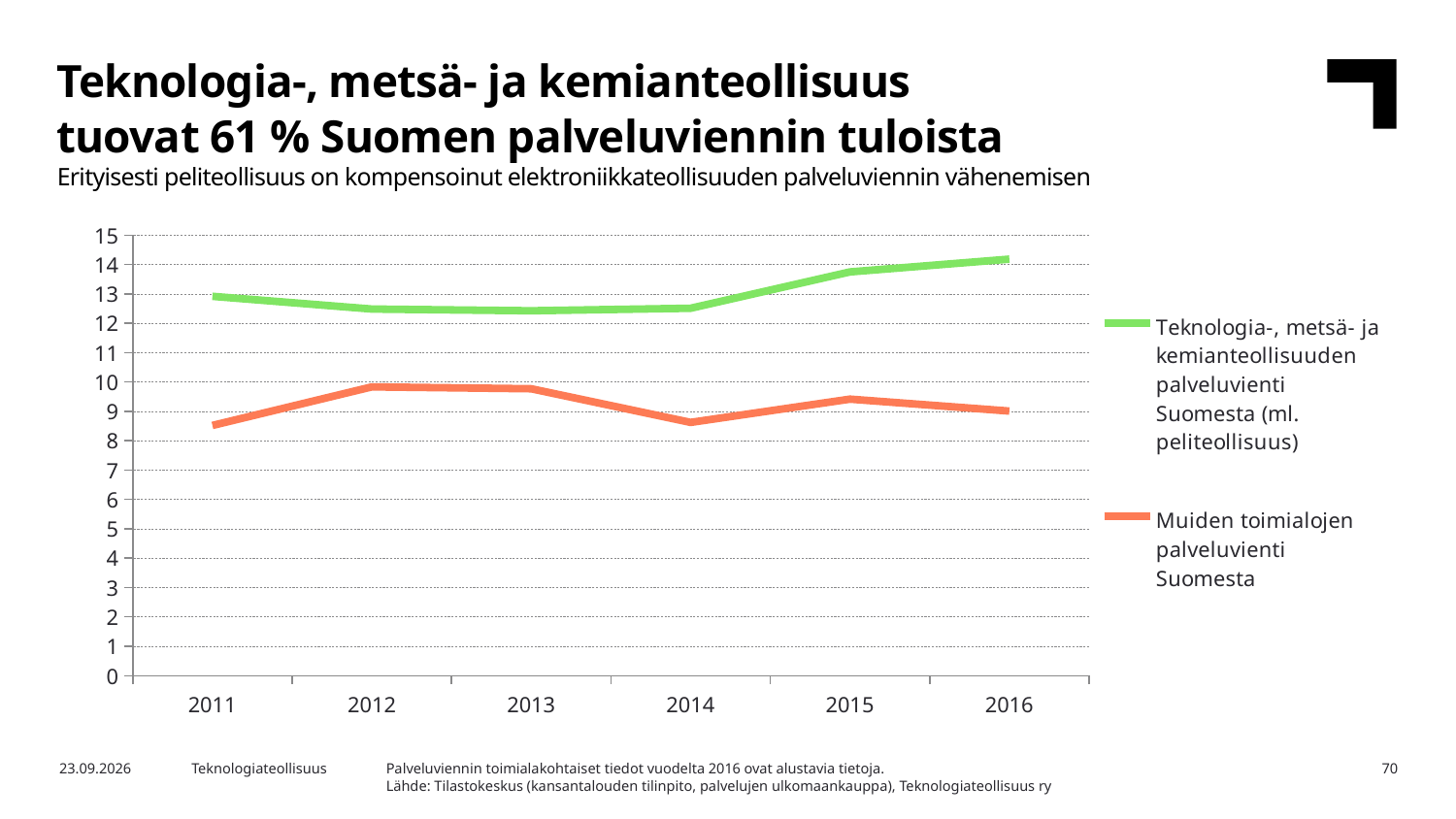
Is the value for the green series in 2016 greater or less than 13? greater In 2015, which series has the larger value, the green one or the orange one? the green series (Teknologia-, metsä- ja kemianteollisuuden palveluvienti Suomesta) How many years are shown on the x axis? 6 Does the green series rise or fall from 2014 to 2016? rise Is the value for the orange series (Muiden toimialojen palveluvienti Suomesta) in 2014 greater or less than 9? less Which year has the highest value for the green series (Teknologia-, metsä- ja kemianteollisuuden palveluvienti Suomesta)? 2016 How many series does the legend list? 2 Does the orange series rise or fall from 2012 to 2014? fall Is the value for the green series in 2011 greater or less than 12? greater What kind of chart is shown on the slide? line chart What colour is the line for Muiden toimialojen palveluvienti Suomesta? orange